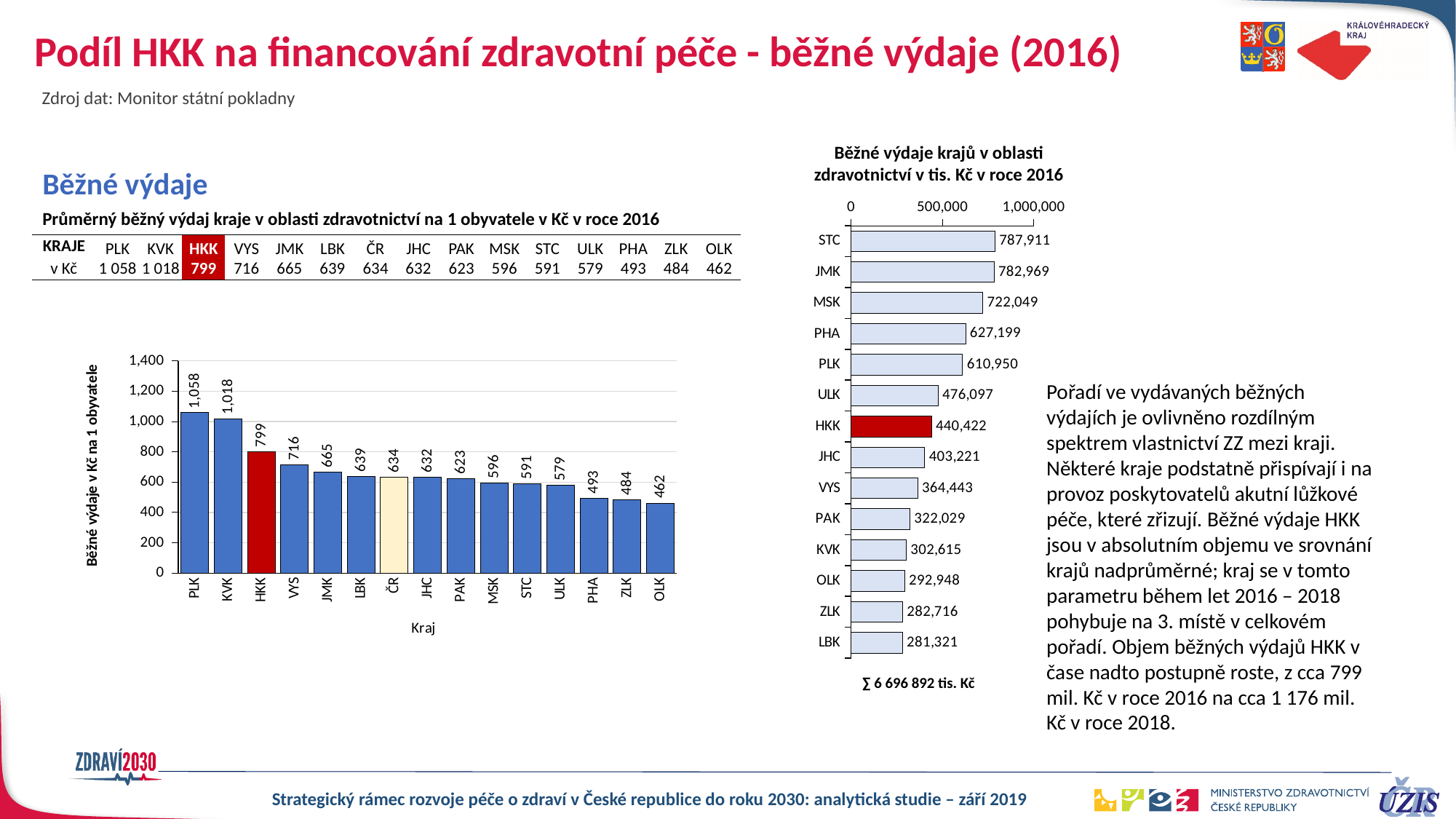
In the left bar chart (Běžné výdaje v Kč na 1 obyvatele), which region has the highest value? PLK In the right chart (Běžné výdaje krajů v oblasti zdravotnictví v tis. Kč v roce 2016), which region has the highest value? STC In the left bar chart (Běžné výdaje v Kč na 1 obyvatele), do the values rise or fall from left to right? fall In the left bar chart (Běžné výdaje v Kč na 1 obyvatele), what is the difference between PLK and KVK? 40 What kind of chart is the left chart (Běžné výdaje v Kč na 1 obyvatele)? bar chart In the right chart (Běžné výdaje krajů v oblasti zdravotnictví v tis. Kč v roce 2016), how many regions are plotted? 14 In the right chart (Běžné výdaje krajů v oblasti zdravotnictví v tis. Kč v roce 2016), which is larger, ULK or JHC? ULK In the left bar chart (Běžné výdaje v Kč na 1 obyvatele), which region has the lowest value? OLK In the right chart (Běžné výdaje krajů v oblasti zdravotnictví v tis. Kč v roce 2016), what is the difference between STC and JMK? 4,942 In the left bar chart (Běžné výdaje v Kč na 1 obyvatele), what is the value for HKK? 799 In the left bar chart (Běžné výdaje v Kč na 1 obyvatele), how many bars are plotted? 15 In the right chart (Běžné výdaje krajů v oblasti zdravotnictví v tis. Kč v roce 2016), what is the value for HKK? 440,422